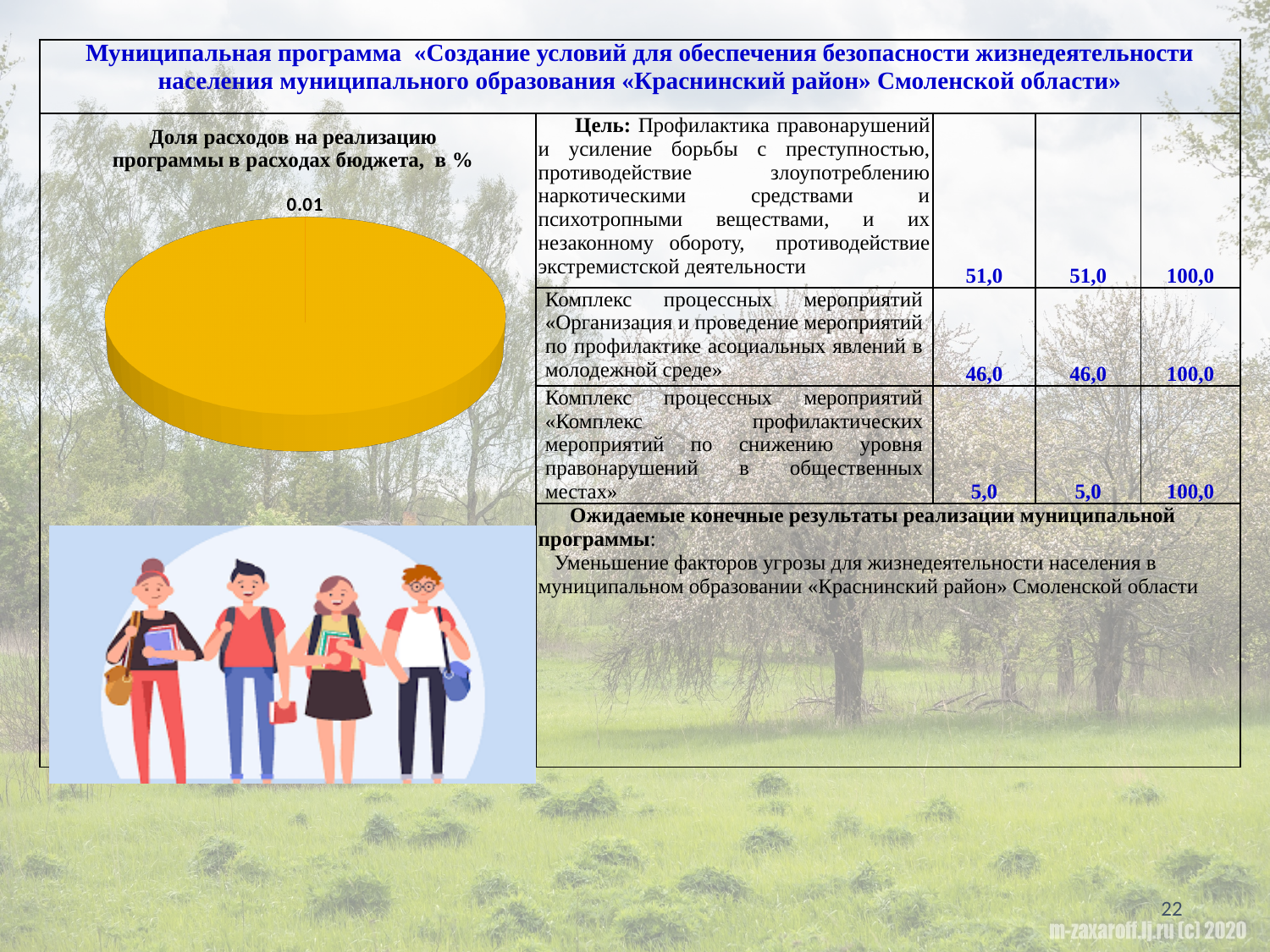
What kind of chart is shown on the slide? pie chart How many slices does the pie chart have? 1 What value is printed as the data label on the pie chart? 0.01 Is the value shown on the pie chart greater or less than 1? less What colour is the slice of the pie chart? yellow/orange What is the title of the pie chart? Доля расходов на реализацию программы в расходах бюджета, в %